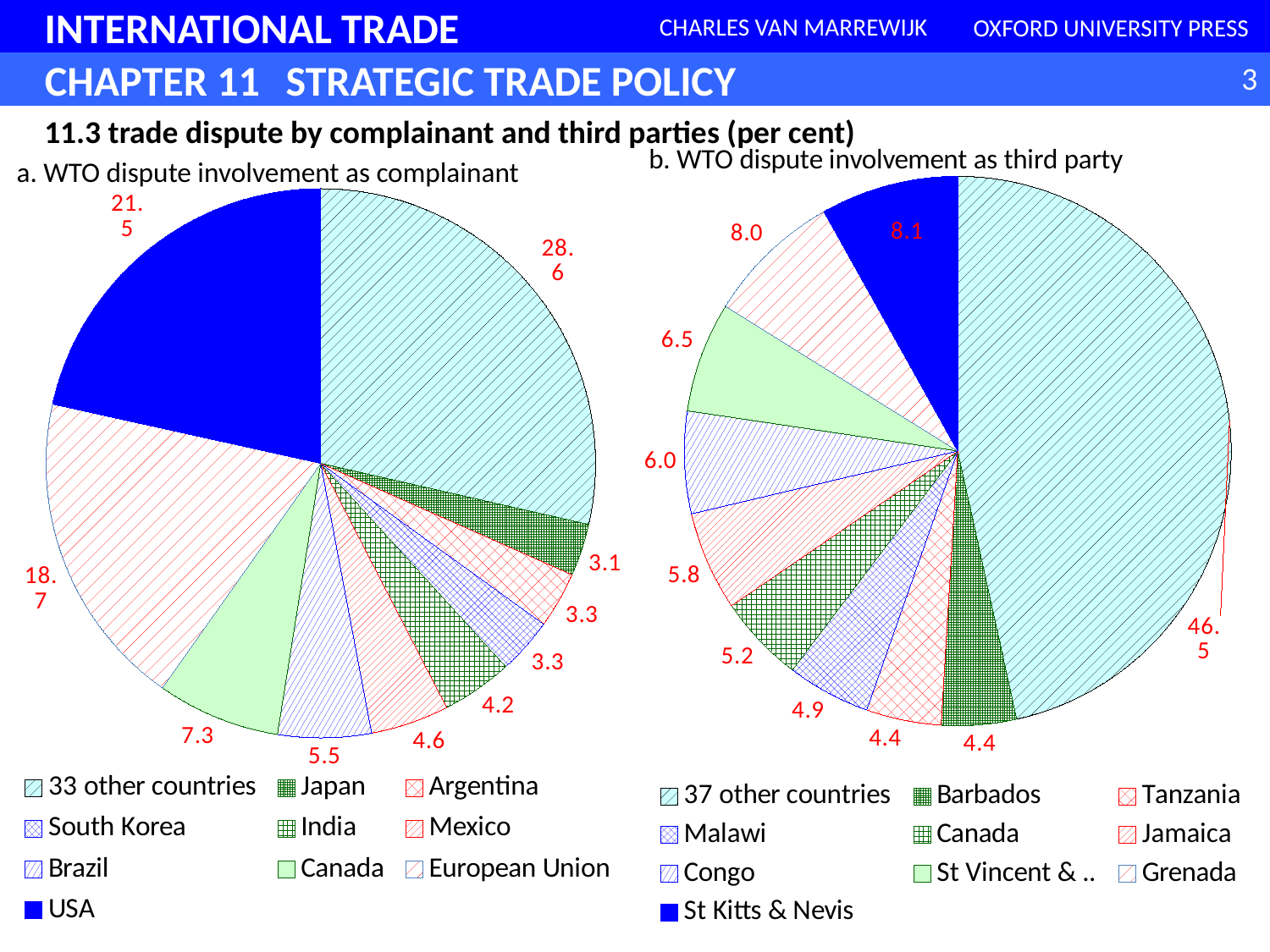
In the chart 'b. WTO dispute involvement as third party', which category has the largest slice? 37 other countries In the chart 'a. WTO dispute involvement as complainant', which is larger, Canada or Brazil? Canada In the chart 'a. WTO dispute involvement as complainant', what is the difference between the values for USA and European Union? 2.8 In the chart 'b. WTO dispute involvement as third party', what is the difference between the values for 37 other countries and St Kitts & Nevis? 38.4 In the chart 'b. WTO dispute involvement as third party', what is the value for St Kitts & Nevis? 8.1 In the chart 'b. WTO dispute involvement as third party', what is the value for 37 other countries? 46.5 In the chart 'a. WTO dispute involvement as complainant', which category has the largest slice? 33 other countries In the chart 'a. WTO dispute involvement as complainant', what is the value for USA? 21.5 How many slices does the chart 'b. WTO dispute involvement as third party' have? 10 In the chart 'a. WTO dispute involvement as complainant', which category has the smallest slice? Japan In the chart 'a. WTO dispute involvement as complainant', what is the value for European Union? 18.7 What kind of chart is 'a. WTO dispute involvement as complainant'? Pie chart